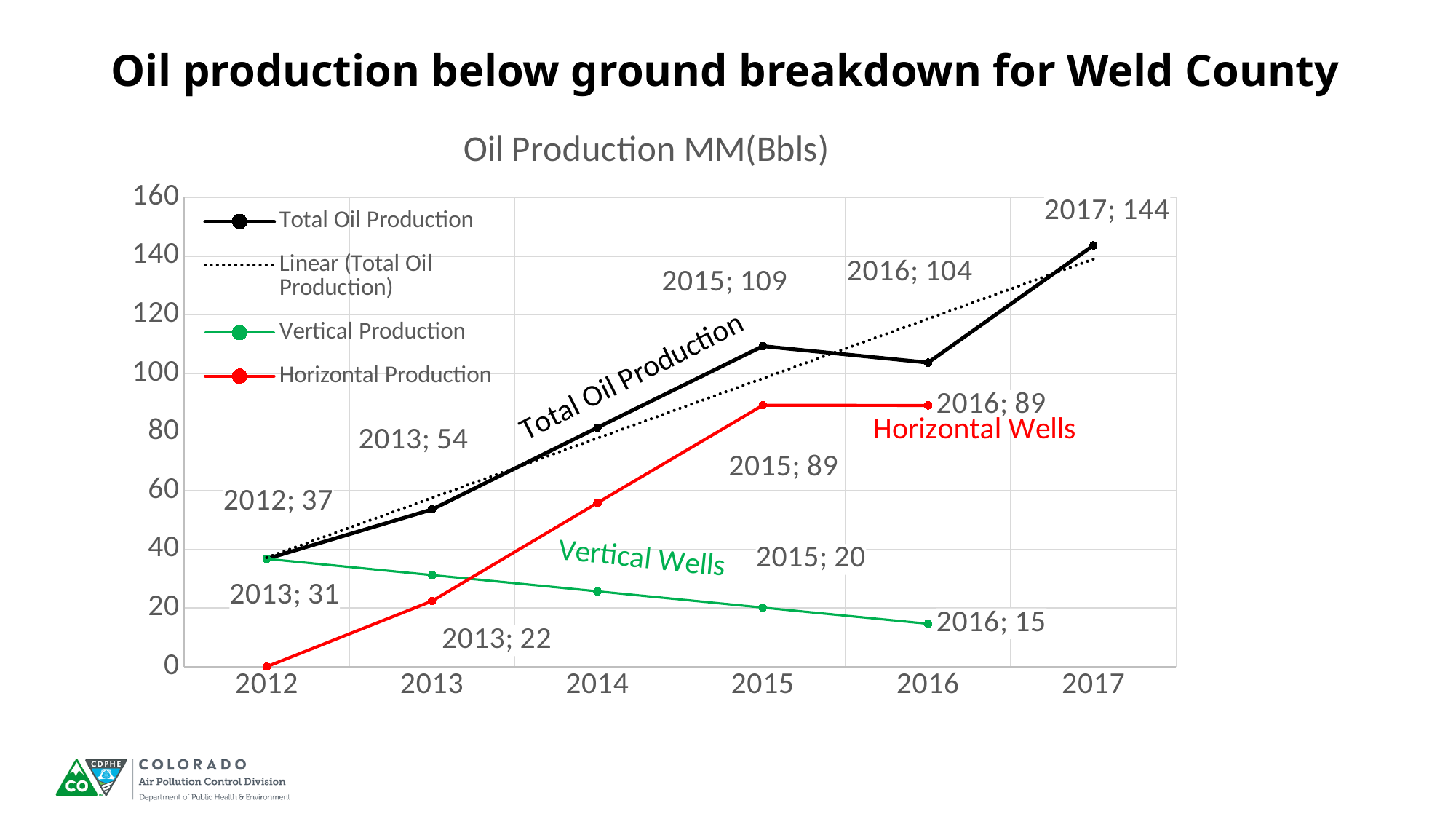
In which year is Vertical Production lowest? 2016 Does Vertical Production rise or fall from 2012 to 2016? fall What is the Horizontal Production value for 2015? 89 Is the Horizontal Production value for 2014 greater or less than 40? greater What is the Total Oil Production value for 2017? 144 Which is larger, Total Oil Production in 2015 or in 2016? 2015 What is the Vertical Production value for 2016? 15 In which year is Total Oil Production highest? 2017 Is the Total Oil Production value for 2014 greater or less than 100? less What kind of chart is shown on the slide? line chart How many series does the legend list? 4 What is the difference between Total Oil Production in 2017 and in 2016? 40